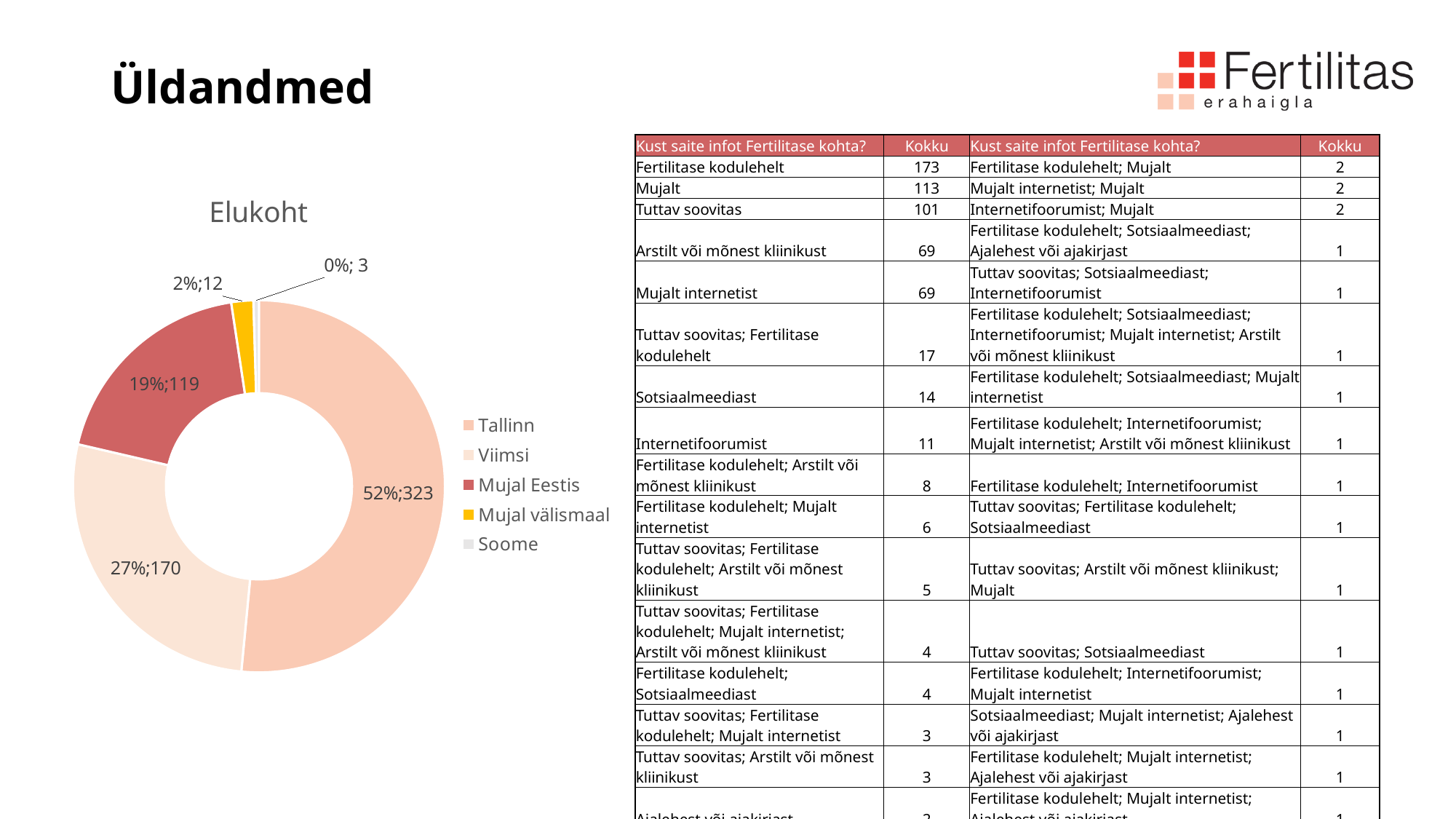
What is the count shown for Tallinn in the "Elukoht" chart? 323 What percentage share does Viimsi have in the "Elukoht" chart? 27% What is the count shown for Mujal välismaal in the "Elukoht" chart? 12 Which colour represents Mujal välismaal in the "Elukoht" chart? yellow What is the count shown for Mujal Eestis in the "Elukoht" chart? 119 Which category has the smallest share in the "Elukoht" chart? Soome What kind of chart is the "Elukoht" chart? doughnut chart How many categories does the "Elukoht" chart show? 5 In the "Elukoht" chart, what is the difference between the counts for Tallinn and Viimsi? 153 What is the title of the chart on the slide? Elukoht Which category has the largest share in the "Elukoht" chart? Tallinn In the "Elukoht" chart, which is larger: Viimsi or Mujal Eestis? Viimsi